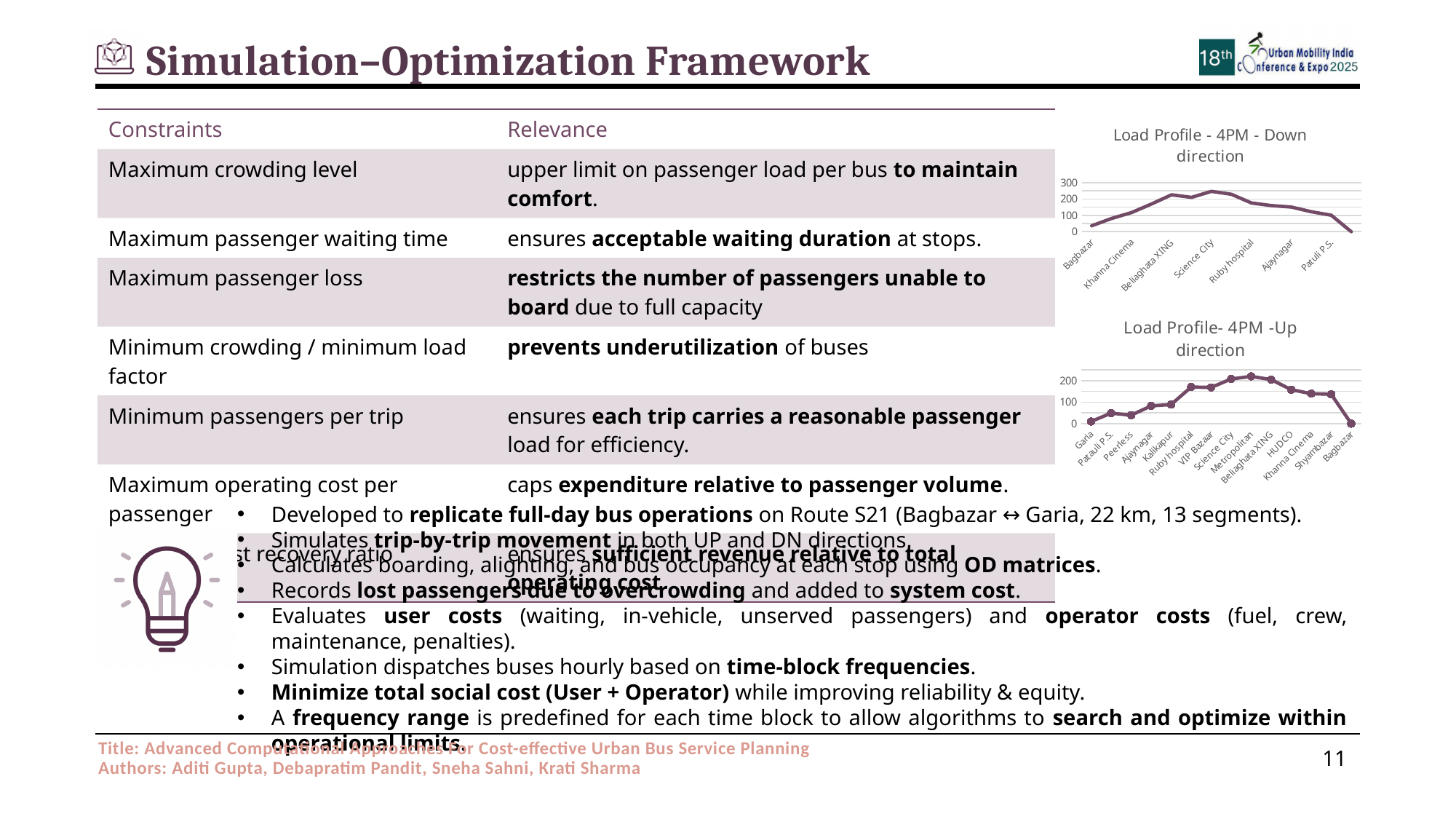
In the 'Load Profile- 4PM -Up direction' chart, is the value for Peerless greater or less than 100? less In the 'Load Profile- 4PM -Up direction' chart, do the values rise or fall from Garia to Metropolitan? rise What kind of chart is the 'Load Profile - 4PM - Down direction' chart? line chart In the 'Load Profile - 4PM - Down direction' chart, which is larger, the value for Science City or the value for Bagbazar? Science City In the 'Load Profile - 4PM - Down direction' chart, is the value for Bagbazar greater or less than 100? less In the 'Load Profile - 4PM - Down direction' chart, is the value for Science City greater or less than 200? greater In the 'Load Profile - 4PM - Down direction' chart, which stop has the highest load? Science City What is the title of the upper chart on the right of the slide? Load Profile - 4PM - Down direction In the 'Load Profile- 4PM -Up direction' chart, which stop has the highest load? Metropolitan In the 'Load Profile- 4PM -Up direction' chart, how many stops are plotted along the x axis? 14